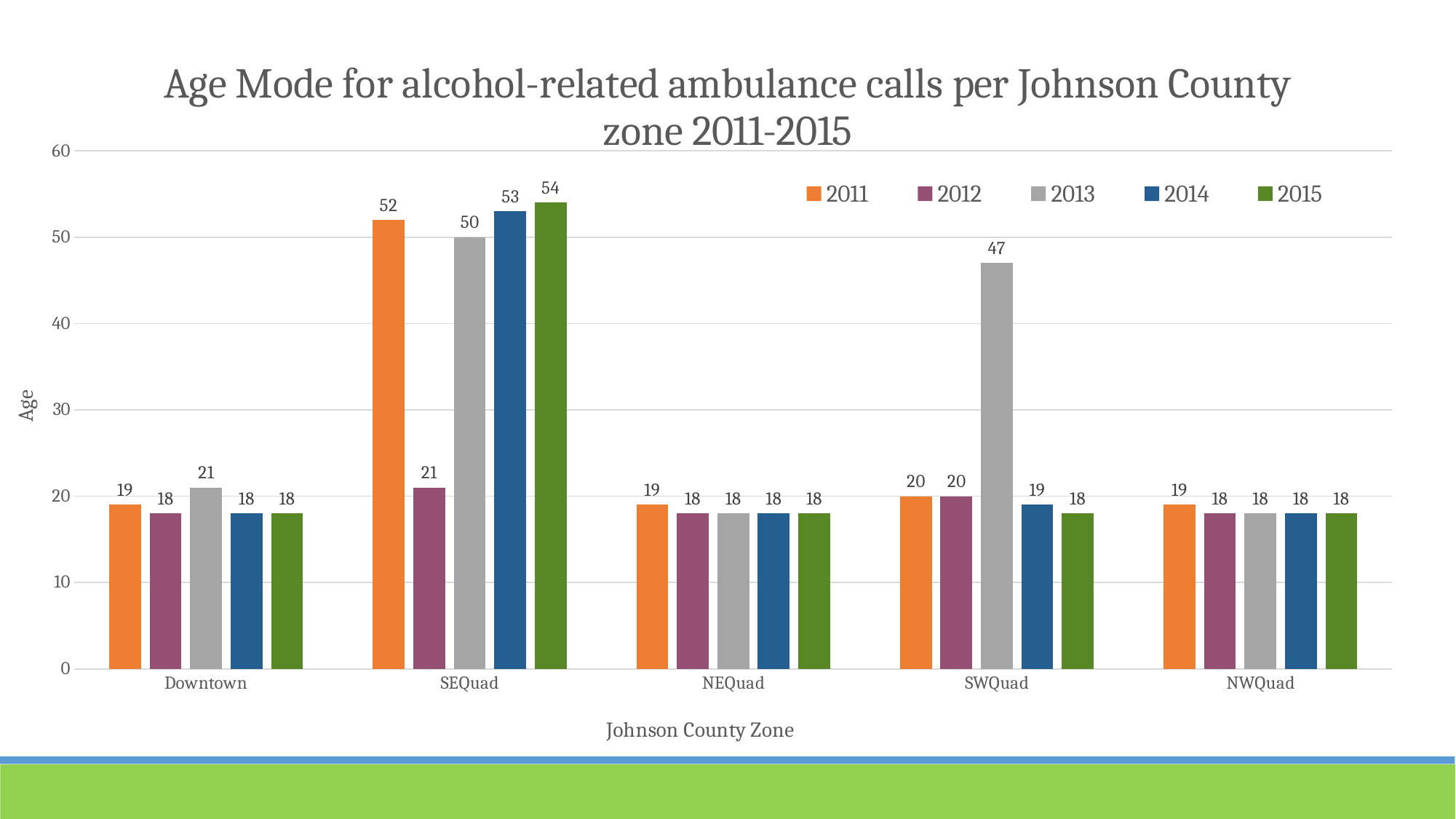
How many zones are shown on the x axis? 5 Which year has the lowest age mode for SEQuad? 2012 What is the age mode for SEQuad in 2015? 54 What is the age mode for SWQuad in 2013? 47 What is the age mode for NWQuad in 2011? 19 Which zone has the highest age mode in 2014? SEQuad Which is larger, the 2011 age mode for SEQuad or the 2013 age mode for SWQuad? 2011 age mode for SEQuad What is the difference between the 2013 and 2014 age modes for SWQuad? 28 What kind of chart is shown on the slide? Bar chart How many series does the legend list? 5 What is the age mode for Downtown in 2013? 21 What is the label of the y axis? Age